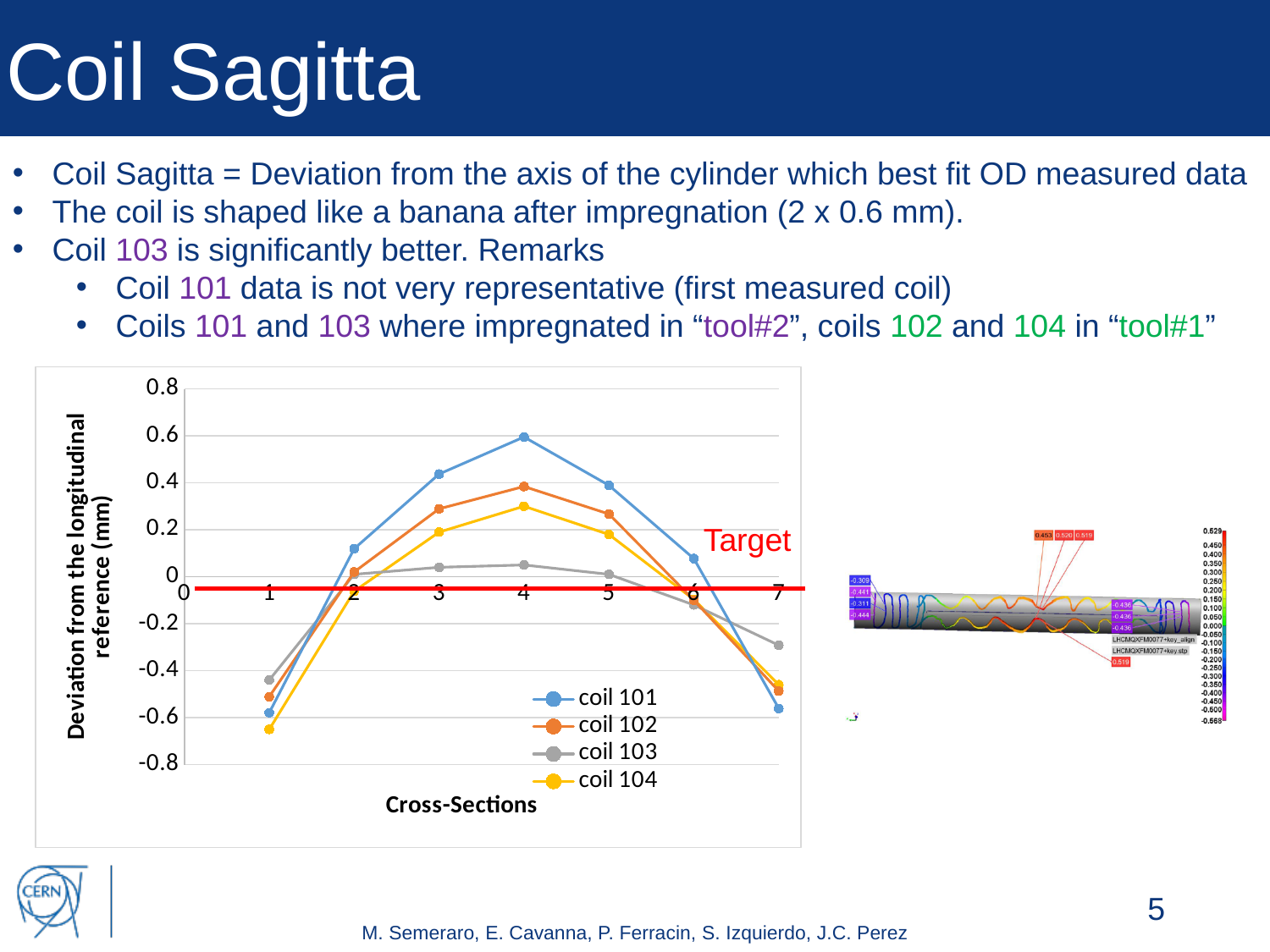
Is the value for coil 103 at cross-section 4 greater or less than 0.2? less Is the value for coil 101 at cross-section 4 greater or less than 0.4? greater What label is written next to the red horizontal line on the chart? Target Which coil has the highest deviation at cross-section 4? coil 101 Which coil has the highest value at cross-section 7? coil 103 How many cross-sections are plotted along the x axis? 7 How many series does the chart legend list? 4 Is the value for coil 104 at cross-section 1 greater or less than -0.6? less What kind of chart is shown on the slide? line chart At cross-section 3, which is larger: the value for coil 101 or the value for coil 104? coil 101 Do the values for coil 101 rise or fall from cross-section 4 to cross-section 7? fall What is the title of the y axis of the chart? Deviation from the longitudinal reference (mm)